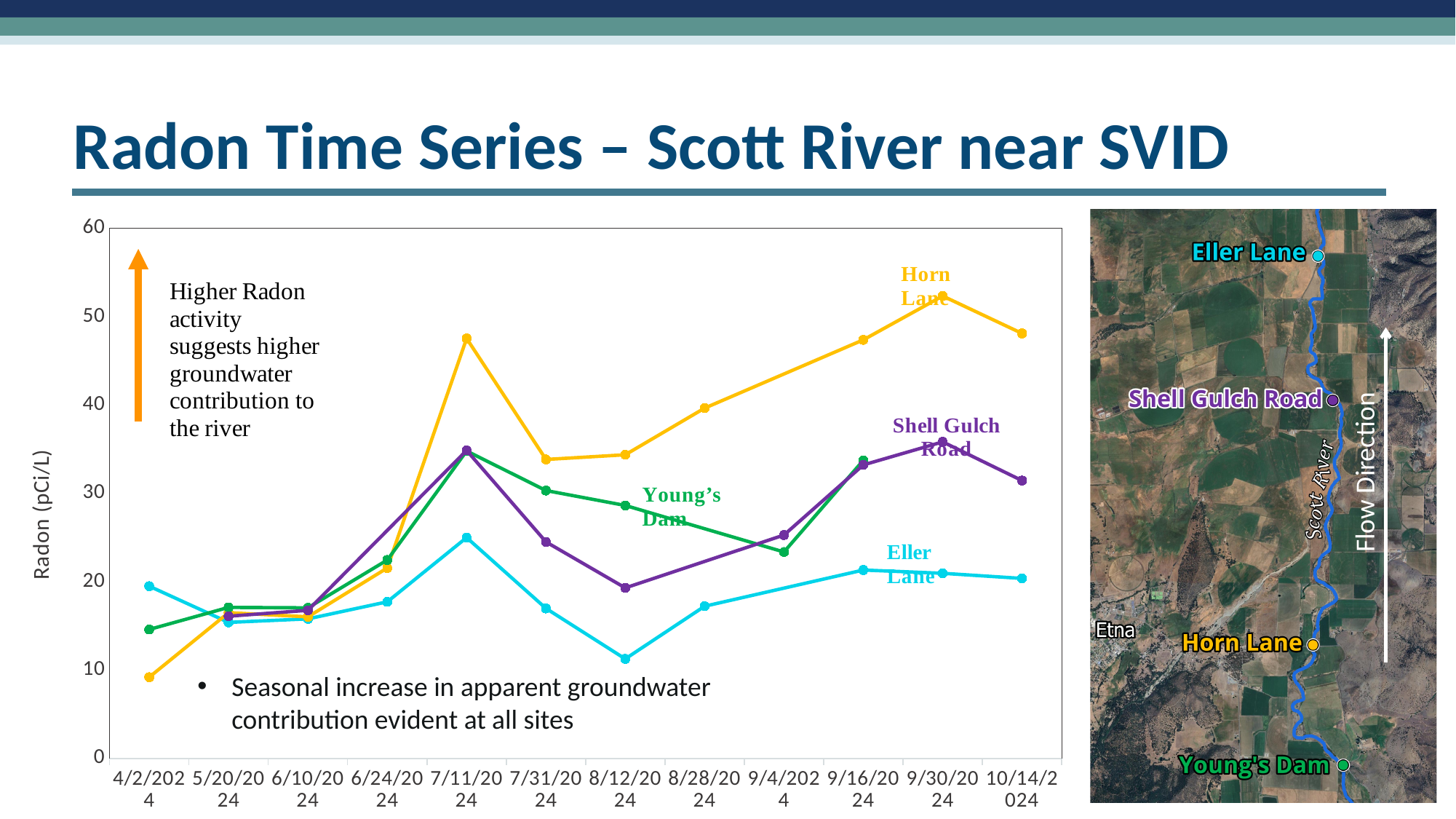
What is the label on the y axis of the chart? Radon (pCi/L) How many sites (series) are plotted on the chart? 4 Which site has the lowest radon value on 4/2/2024? Horn Lane Does the Horn Lane line rise or fall between 7/31/2024 and 9/30/2024? rises Which site has the lowest radon value on 8/12/2024? Eller Lane On 7/31/2024, which is larger: the value for Young's Dam or the value for Shell Gulch Road? Young's Dam Is the value for Shell Gulch Road on 9/30/2024 greater or less than 30? greater How many dates are shown along the x axis of the chart? 12 Which site has the highest radon value on 9/30/2024? Horn Lane Is the value for Eller Lane on 8/12/2024 greater or less than 20? less What kind of chart is shown on the slide? line chart Is the value for Horn Lane on 7/11/2024 greater or less than 40? greater